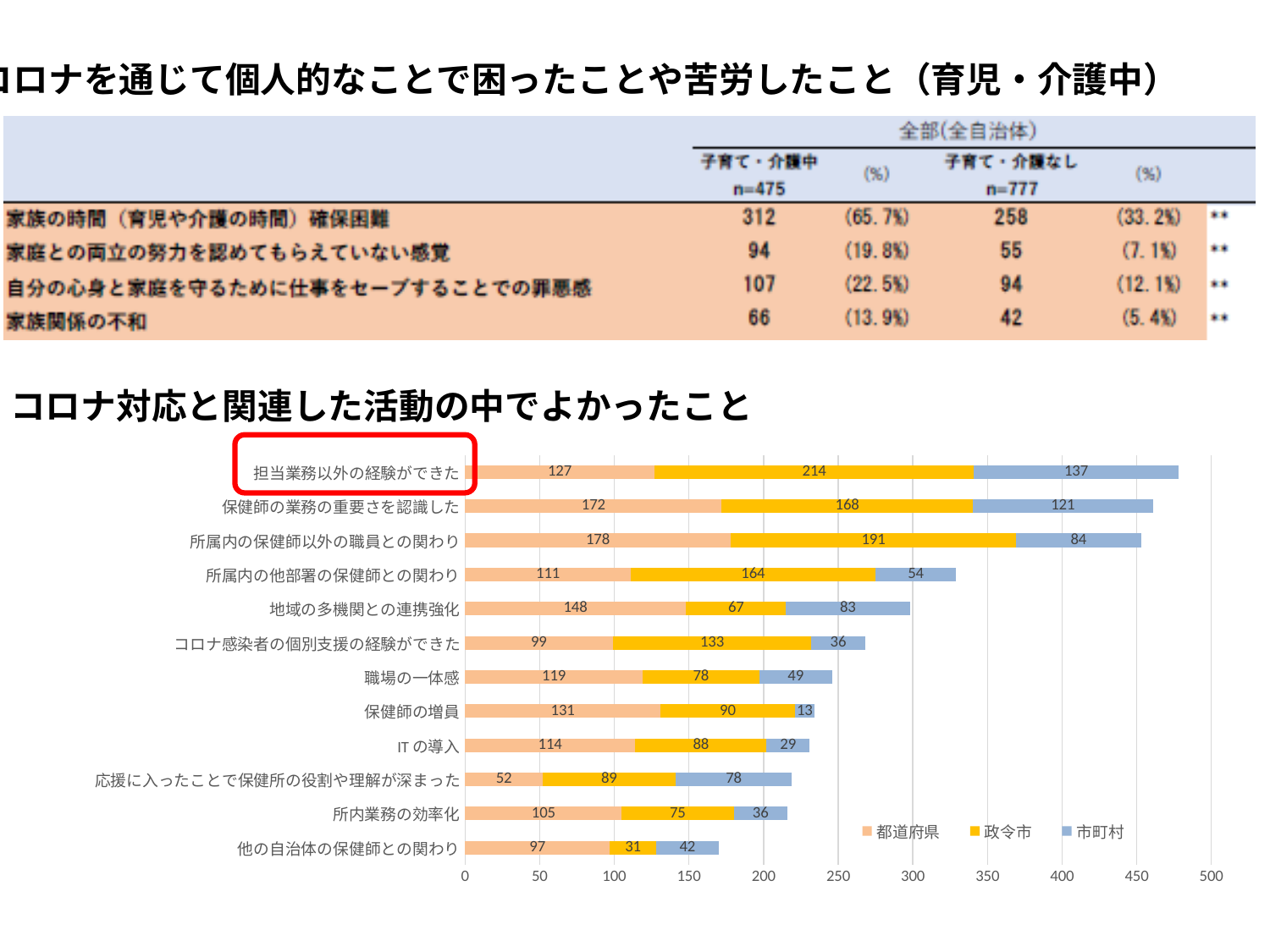
In the bar chart, what is the difference between the 都道府県 values for 保健師の業務の重要さを認識した and 担当業務以外の経験ができた? 45 In the bar chart, what is the 市町村 value for 保健師の増員? 13 In the bar chart, what is the 都道府県 value for 所属内の保健師以外の職員との関わり? 178 How many categories are shown in the bar chart? 12 In the bar chart, what is the 政令市 value for 担当業務以外の経験ができた? 214 In the bar chart, which is larger: the 市町村 value for 地域の多機関との連携強化 or the 市町村 value for 所属内の他部署の保健師との関わり? 地域の多機関との連携強化 What type of chart is shown under the heading コロナ対応と関連した活動の中でよかったこと? Stacked bar chart In the bar chart, which category has the highest 政令市 value? 担当業務以外の経験ができた In the bar chart, what is the total of the stacked bar for 担当業務以外の経験ができた? 478 Which series in the bar chart is shown in yellow? 政令市 How many series does the legend of the bar chart list? 3 In the bar chart, which category has the lowest 市町村 value? 保健師の増員